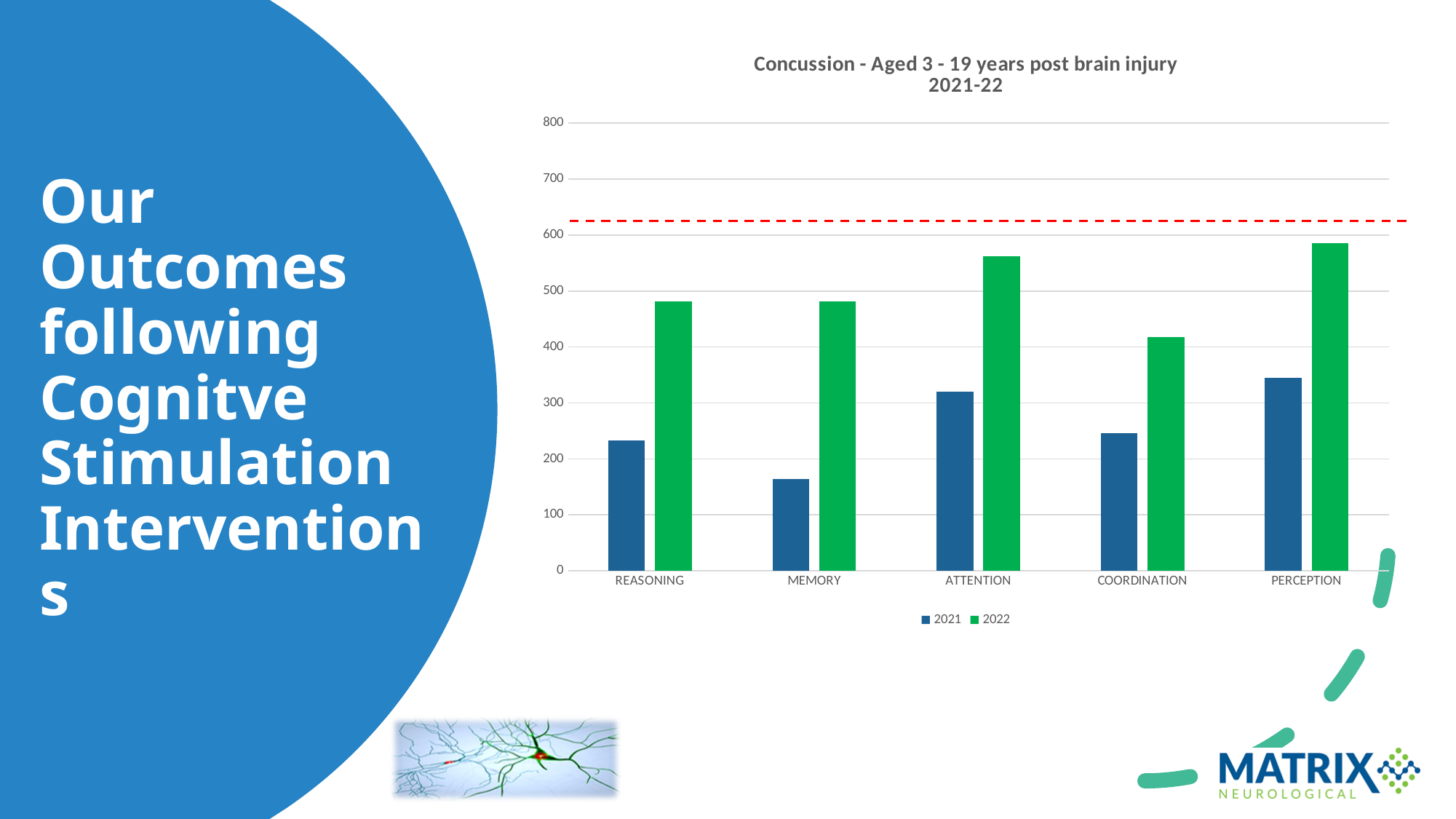
Which category has the highest value for the 2021 series? PERCEPTION What is the title of the chart? Concussion - Aged 3 - 19 years post brain injury 2021-22 Which category has the lowest value for the 2022 series? COORDINATION How many series does the legend list? 2 Is the 2022 value for COORDINATION greater or less than 500? less Is the 2021 value for MEMORY greater or less than 200? less What type of chart is shown on the slide? Bar chart Is the 2022 value for ATTENTION greater or less than 500? greater Which category has the lowest value for the 2021 series? MEMORY How many categories are shown on the x axis? 5 In every category, is the 2022 bar higher or lower than the 2021 bar? higher Which is larger, the 2021 value for ATTENTION or the 2021 value for COORDINATION? ATTENTION